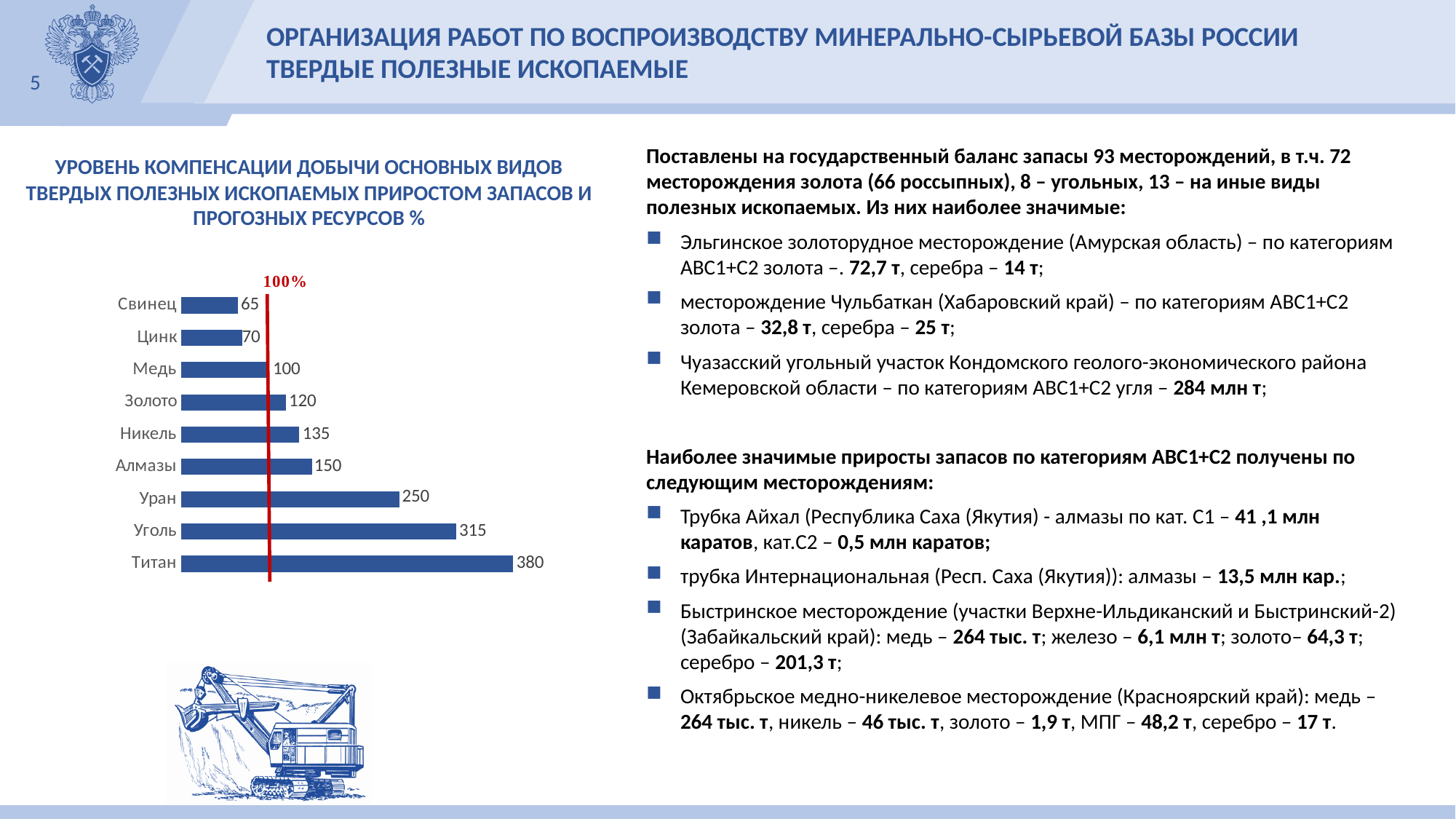
Which category has the highest value in the chart? Титан Which category has a value exactly equal to the 100% reference line? Медь Which has a larger value, Никель or Алмазы? Алмазы What is the difference between the values for Уголь and Уран? 65 What is the value for Свинец in the chart? 65 What type of chart is shown on the slide? bar chart Which category has the lowest value in the chart? Свинец What is the value for Уран in the chart? 250 What value does the red vertical reference line in the chart mark? 100% How many categories (mineral types) are plotted in the chart? 9 What is the difference between the values for Золото and Цинк? 50 What is the value for Титан in the chart? 380